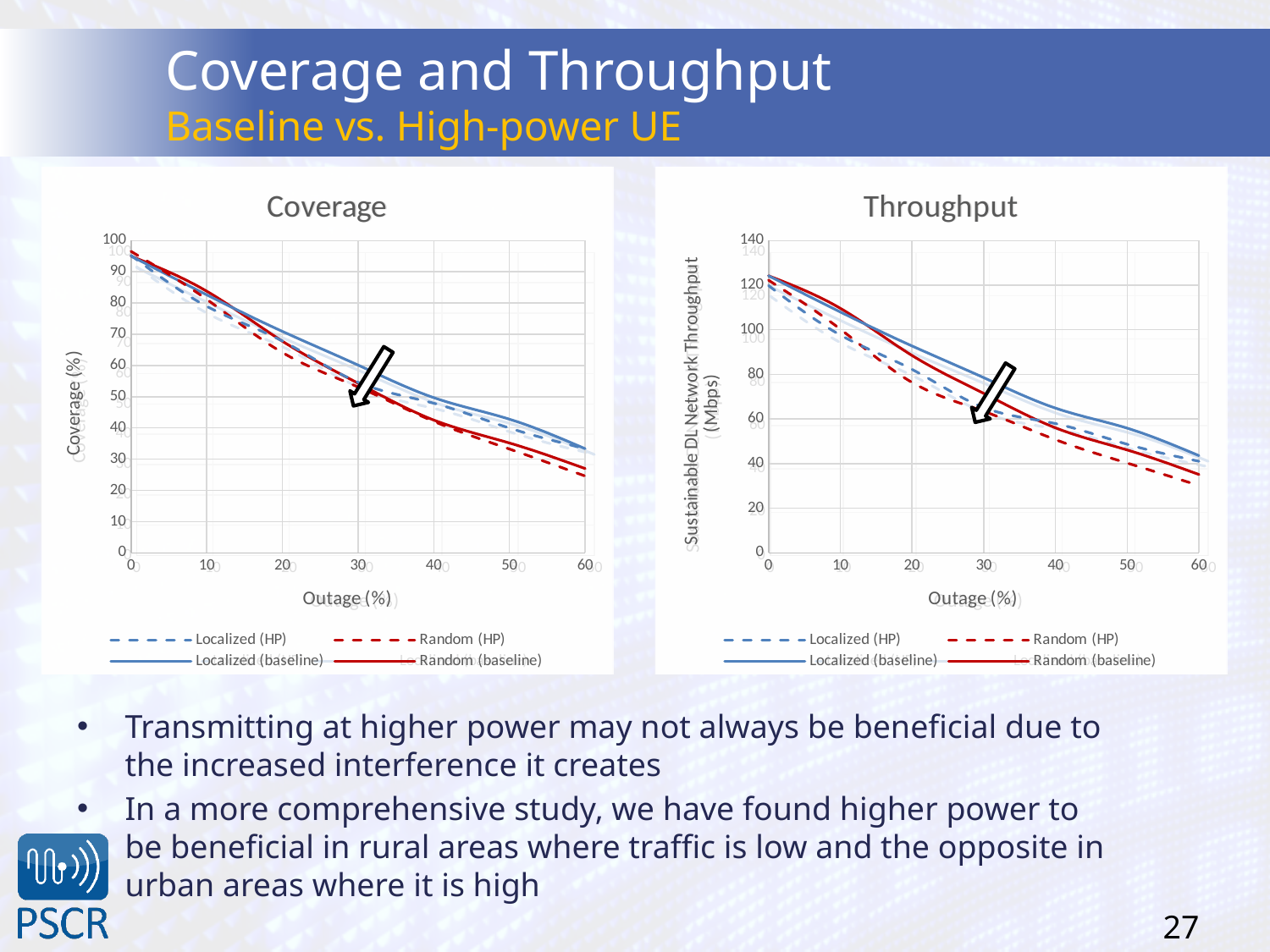
In the Throughput chart, at an outage of 60, which series is higher: Localized (baseline) or Random (HP)? Localized (baseline) What kind of chart is the Coverage chart on the left? line chart How many series does the legend of the Throughput chart list? 4 In the Throughput chart, is the Random (HP) value at an outage of 60 greater or less than 40? less In the Coverage chart, is the Random (HP) value at an outage of 30 greater or less than 60? less In the Coverage chart, do the Localized (baseline) values rise or fall as Outage (%) increases? fall In the Throughput chart, do the Random (HP) values rise or fall as Outage (%) increases? fall In the Coverage chart, is the Random (HP) value at an outage of 60 greater or less than 30? less What kind of chart is the Throughput chart on the right? line chart How many series does the legend of the Coverage chart list? 4 What is the y-axis label of the Throughput chart? Sustainable DL Network Throughput (Mbps)